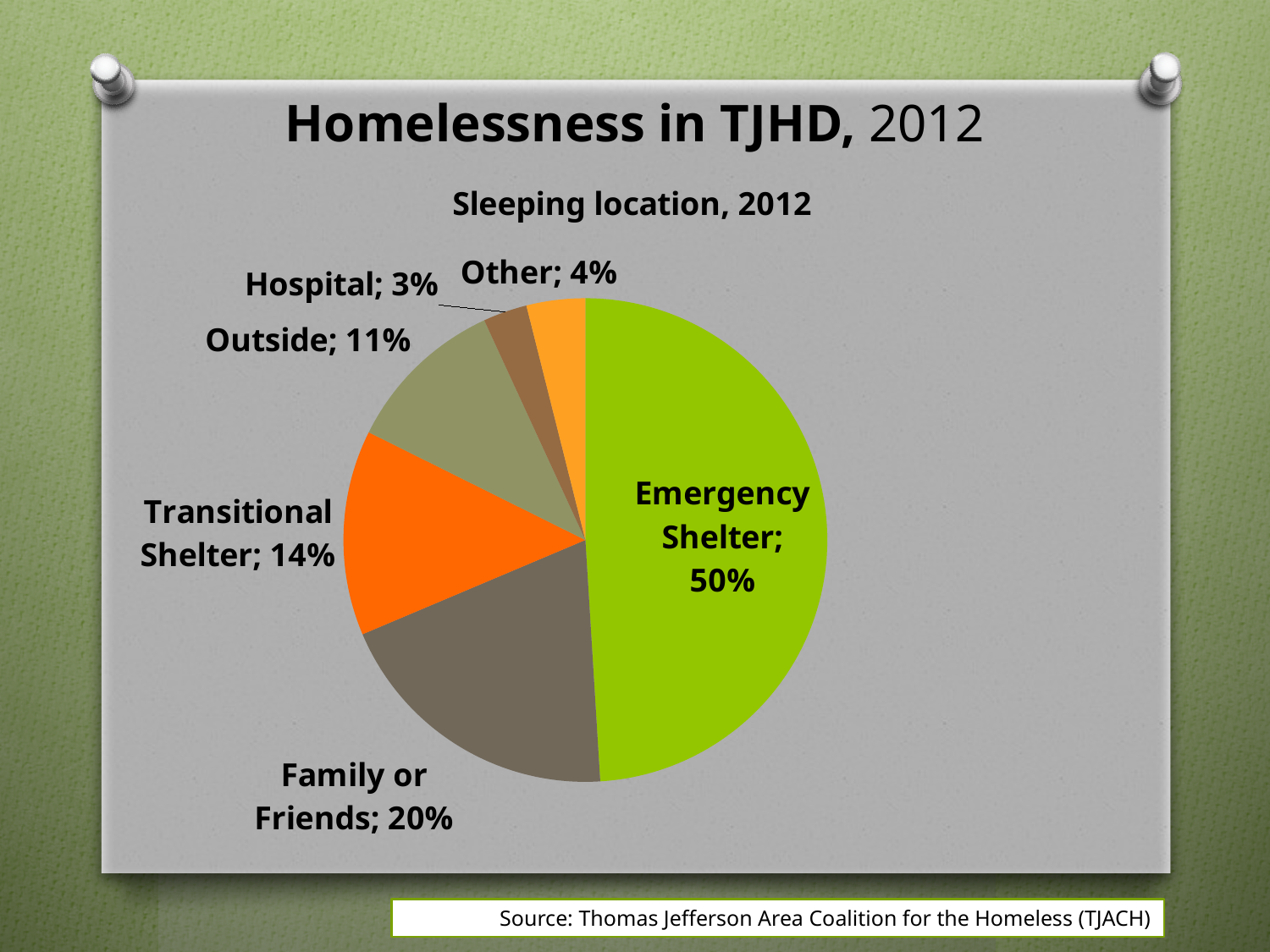
Which sleeping location has the smallest share of the pie? Hospital How many slices does the pie chart have? 6 What share of the pie is Family or Friends? 20% What is the title of the chart? Sleeping location, 2012 Which sleeping location has the largest share of the pie? Emergency Shelter What share of the pie is Hospital? 3% What kind of chart is shown on the slide? Pie chart What share of the pie is Emergency Shelter? 50% What is the difference in percentage points between Emergency Shelter and Family or Friends? 30 What share of the pie is Transitional Shelter? 14% What share of the pie is Outside? 11% Which is larger, the share for Outside or the share for Transitional Shelter? Transitional Shelter